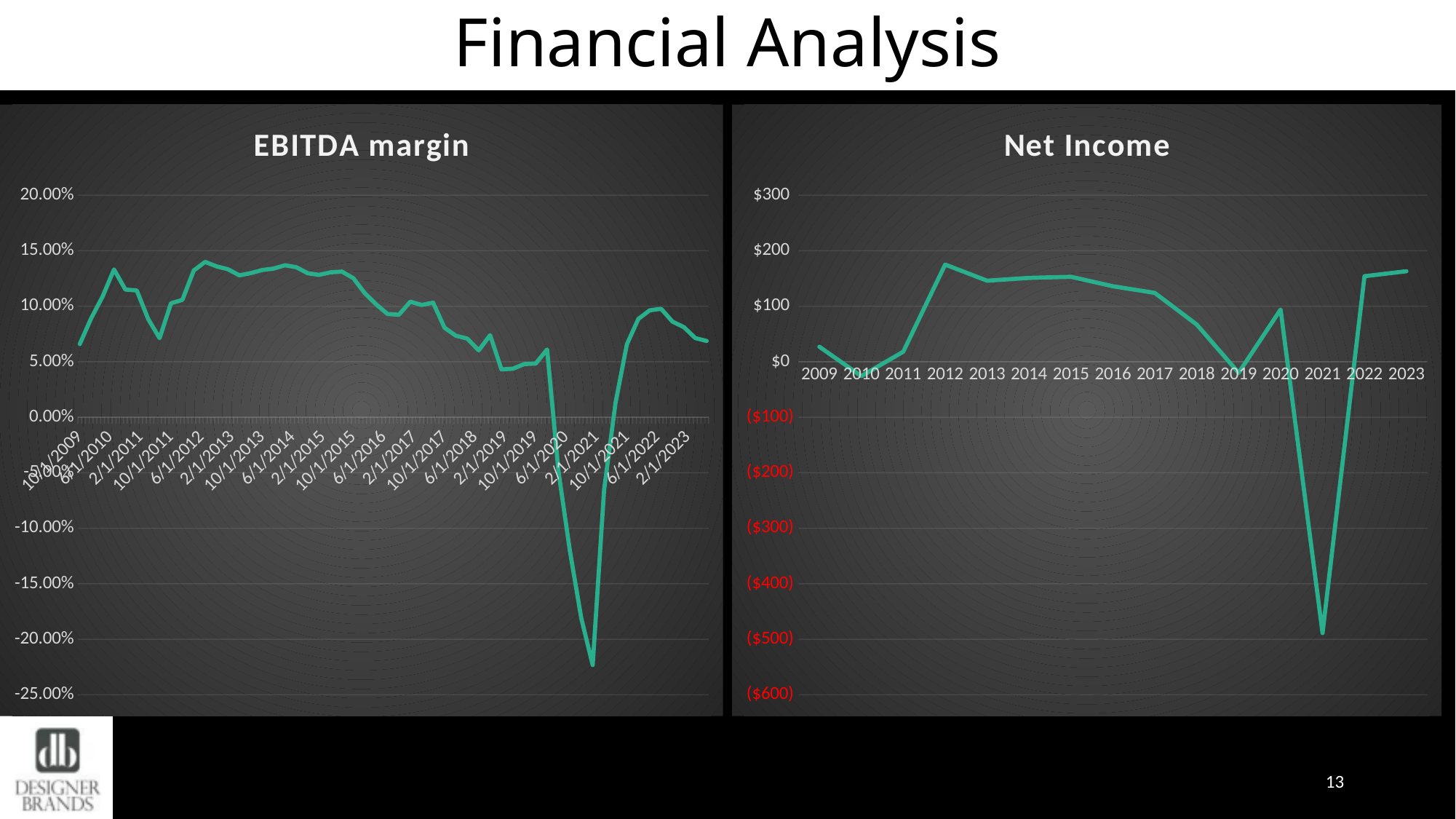
In the Net Income chart, does the value rise or fall from 2017 to 2019? fall In the Net Income chart, is the value for 2019 greater or less than $100? less In the Net Income chart, is the value for 2012 greater or less than $100? greater What kind of chart is the EBITDA margin chart? line chart What kind of chart is the Net Income chart? line chart In the Net Income chart, which year has the lowest net income? 2021 In the Net Income chart, how many years are shown on the x axis? 15 In the EBITDA margin chart, is the value at 6/1/2012 greater or less than 10.00%? greater In the Net Income chart, which is larger, the value for 2012 or the value for 2009? 2012 In the Net Income chart, which is larger, the value for 2020 or the value for 2021? 2020